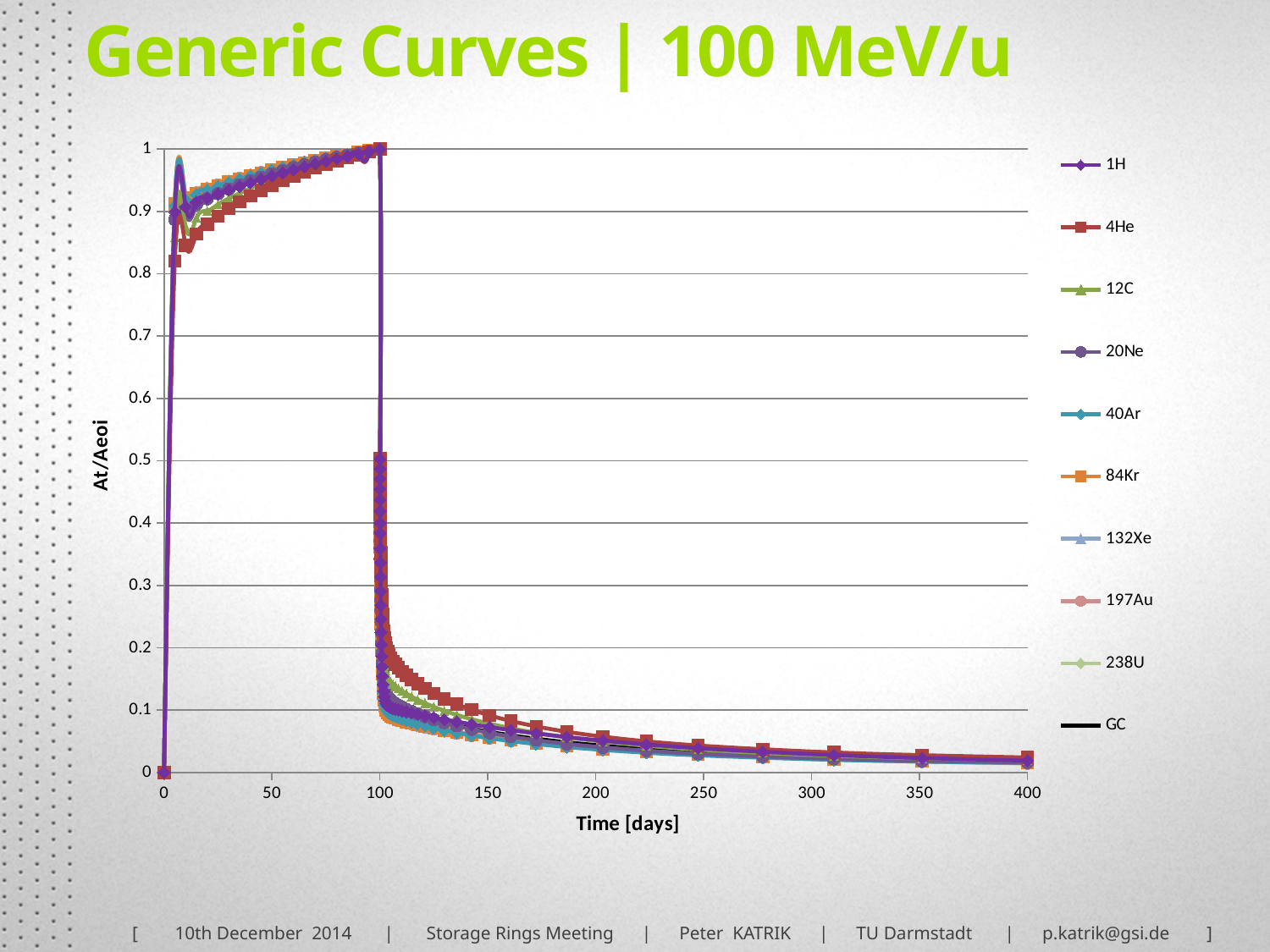
What kind of chart is shown on the slide? line chart What is the label of the x axis? Time [days] At 150 days, which is larger, the value for 4He or the value for 40Ar? 4He Is the value for 4He at 50 days greater or less than 0.9? greater What value do the curves reach at 100 days, just before the sharp drop? 1 Do the curves rise or fall along the x axis between 100 and 400 days? fall Which series has the highest values in the decay tail after 100 days? 4He Do the curves rise or fall along the x axis between 20 and 100 days? rise Is the value for 4He at 300 days greater or less than 0.1? less Is the value for 4He at 10 days greater or less than 0.9? less What is the title of the chart on the slide? Generic Curves | 100 MeV/u How many series does the legend list? 10